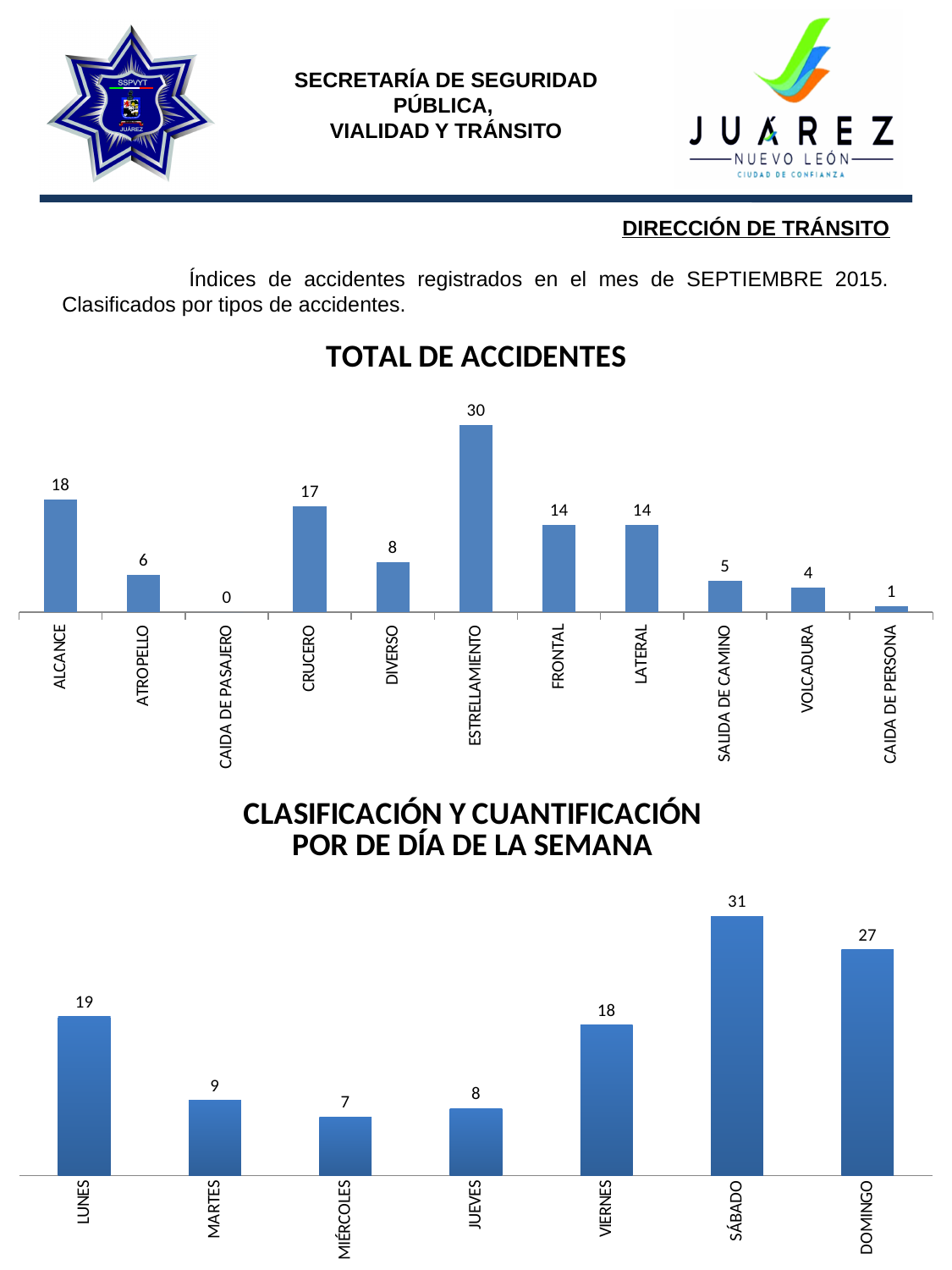
In the 'CLASIFICACIÓN Y CUANTIFICACIÓN POR DE DÍA DE LA SEMANA' chart, which is larger, LUNES or VIERNES? LUNES In the 'CLASIFICACIÓN Y CUANTIFICACIÓN POR DE DÍA DE LA SEMANA' chart, which day has the highest value? SÁBADO In the 'CLASIFICACIÓN Y CUANTIFICACIÓN POR DE DÍA DE LA SEMANA' chart, what is the value for DOMINGO? 27 What kind of chart is the 'CLASIFICACIÓN Y CUANTIFICACIÓN POR DE DÍA DE LA SEMANA' chart? Bar chart In the 'TOTAL DE ACCIDENTES' chart, what is the difference between ALCANCE and CRUCERO? 1 In the 'CLASIFICACIÓN Y CUANTIFICACIÓN POR DE DÍA DE LA SEMANA' chart, which day has the lowest value? MIÉRCOLES In the 'CLASIFICACIÓN Y CUANTIFICACIÓN POR DE DÍA DE LA SEMANA' chart, what is the difference between SÁBADO and VIERNES? 13 In the 'TOTAL DE ACCIDENTES' chart, which category has the highest value? ESTRELLAMIENTO In the 'TOTAL DE ACCIDENTES' chart, what is the value for SALIDA DE CAMINO? 5 In the 'TOTAL DE ACCIDENTES' chart, which category has the lowest value? CAIDA DE PASAJERO In the 'TOTAL DE ACCIDENTES' chart, how many categories are shown? 11 In the 'TOTAL DE ACCIDENTES' chart, what is the value for ESTRELLAMIENTO? 30